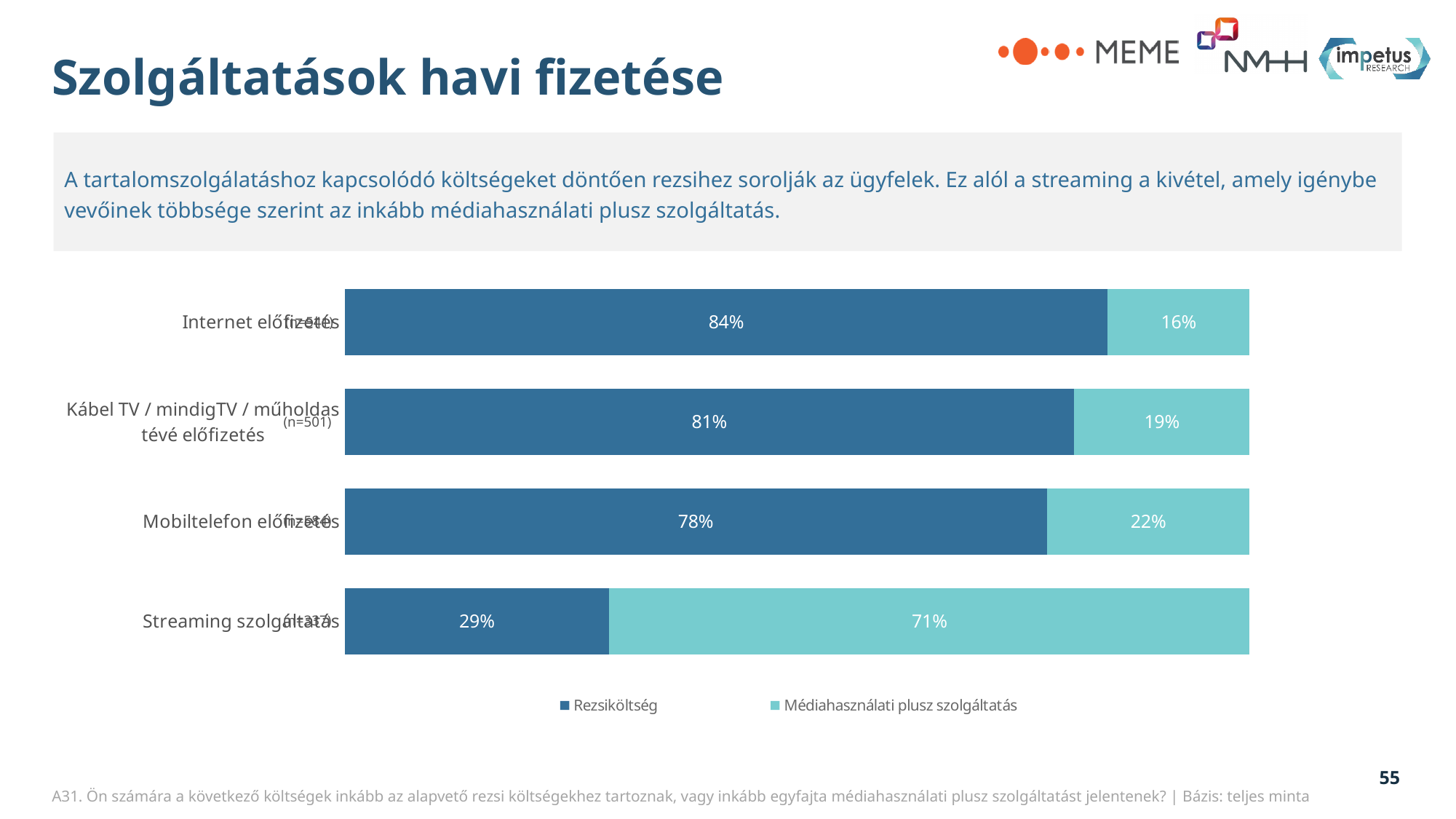
What is the Médiahasználati plusz szolgáltatás value for Streaming szolgáltatás? 71% What is the Rezsiköltség value for Kábel TV / mindigTV / műholdas tévé előfizetés? 81% How many categories are shown in the chart? 4 How many series does the legend list? 2 What is the difference between the Rezsiköltség values for Internet előfizetés and Mobiltelefon előfizetés? 6 percentage points What is the total of the stacked bar for Streaming szolgáltatás? 100% Which category has the highest Rezsiköltség share? Internet előfizetés Which is larger: the Médiahasználati plusz szolgáltatás value for Kábel TV / mindigTV / műholdas tévé előfizetés or for Mobiltelefon előfizetés? Mobiltelefon előfizetés Which category has the lowest Rezsiköltség share? Streaming szolgáltatás What is the Rezsiköltség value for Internet előfizetés? 84% What kind of chart is shown on the slide? Stacked bar chart What is the Médiahasználati plusz szolgáltatás value for Mobiltelefon előfizetés? 22%